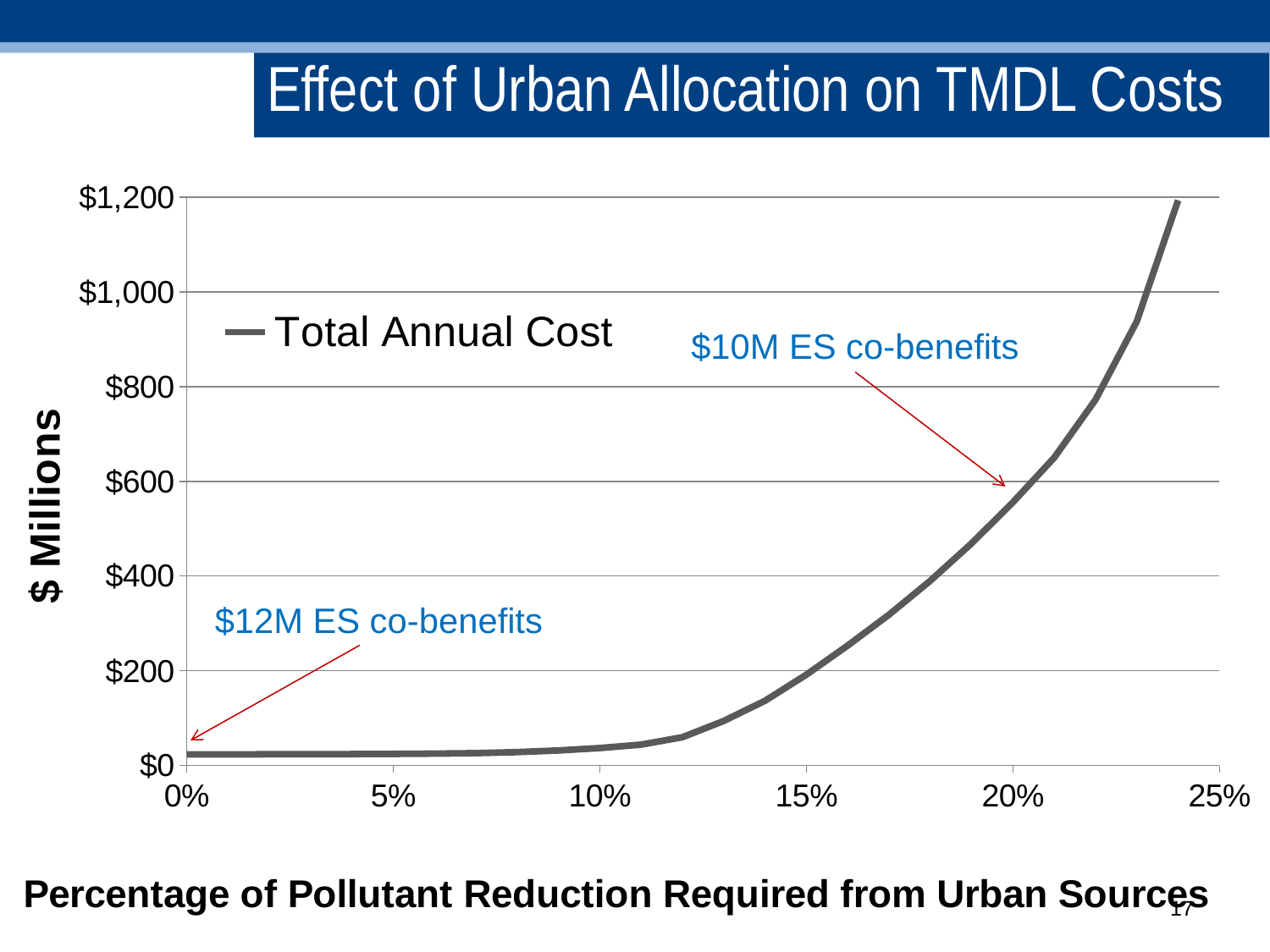
Is the Total Annual Cost at 24% greater or less than $1,000? greater What is the name of the series shown in the legend? Total Annual Cost Is the Total Annual Cost at 22% greater or less than $600? greater How many series does the legend list? 1 What is the title of the chart? Effect of Urban Allocation on TMDL Costs Is the Total Annual Cost at 10% greater or less than $200? less Which is larger, the Total Annual Cost at 10% or at 20%? 20% Does the Total Annual Cost rise or fall as the percentage of pollutant reduction required from urban sources increases? rise What kind of chart is shown on the slide? line chart